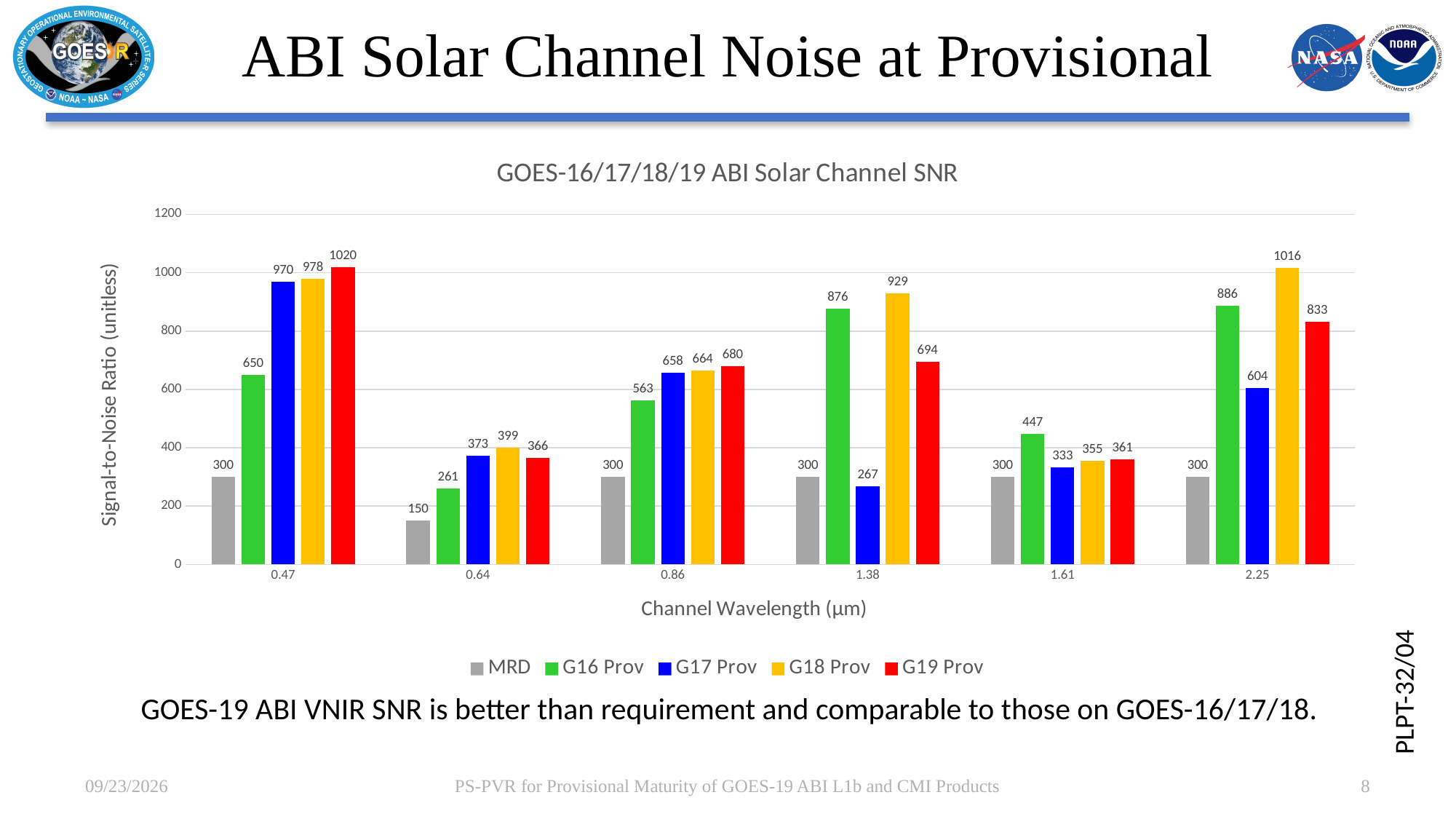
What kind of chart is shown on the slide? Bar chart What is the title of the chart? GOES-16/17/18/19 ABI Solar Channel SNR What is the G17 Prov value at the 1.38 µm channel? 267 How many series does the legend list? 5 What is the G19 Prov value at the 0.47 µm channel? 1020 What is the difference between the G18 Prov and G19 Prov values at the 1.38 µm channel? 235 Which channel wavelength has the lowest G16 Prov value? 0.64 What colour represents the G17 Prov series? Blue How many channel wavelengths are shown on the x axis? 6 Which channel wavelength has the highest G18 Prov value? 2.25 What is the MRD value at the 0.64 µm channel? 150 Which is larger at the 2.25 µm channel, G16 Prov or G19 Prov? G16 Prov